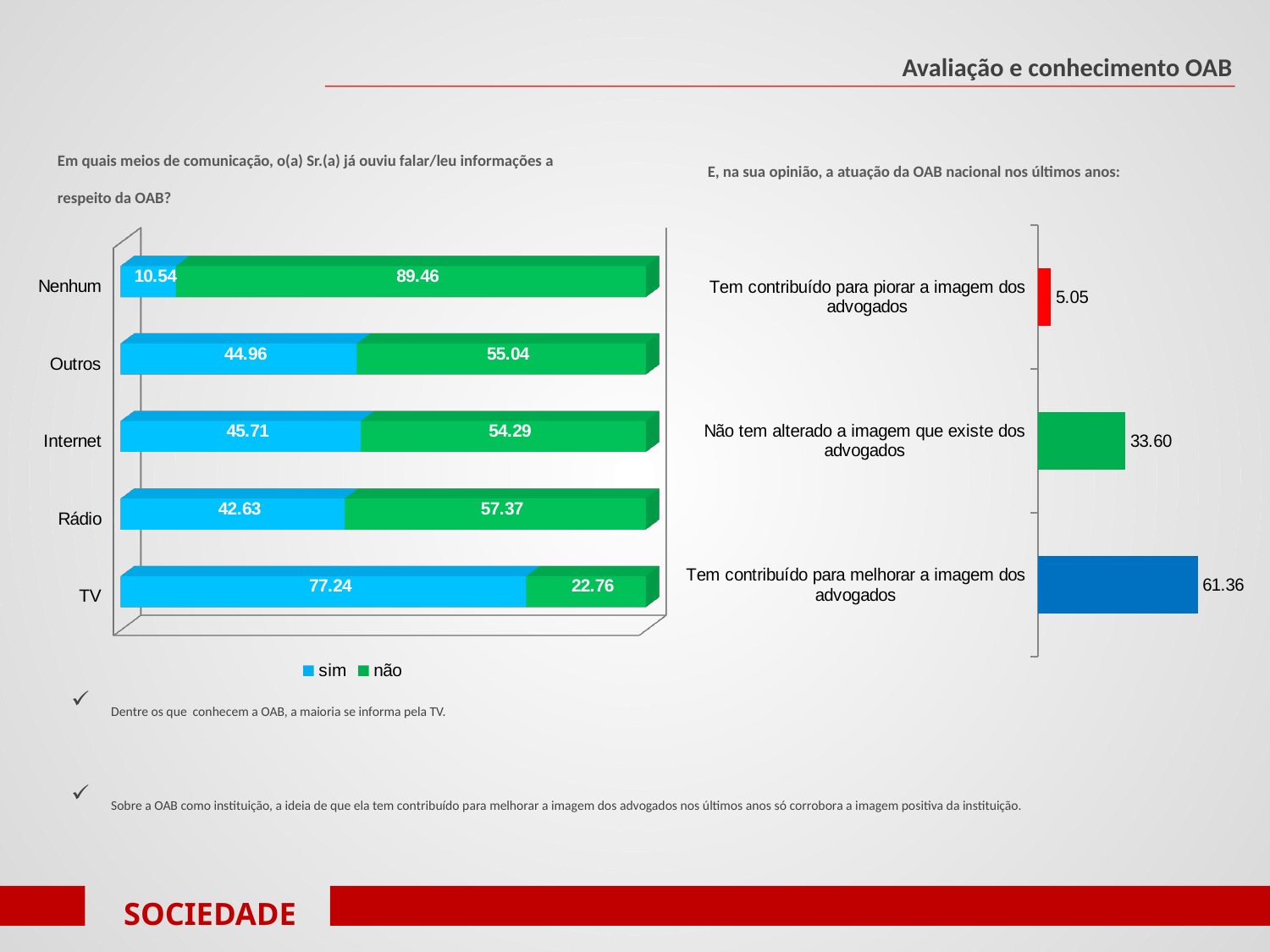
In the left chart (media through which respondents heard about OAB), which category has the highest 'sim' value? TV In the left chart (media through which respondents heard about OAB), how many series does the legend list? 2 In the left chart (media through which respondents heard about OAB), which category has the lowest 'sim' value? Nenhum What kind of chart is the right chart (opinion on OAB's performance in recent years)? Bar chart In the right chart (opinion on OAB's performance in recent years), which category has the lowest value? Tem contribuído para piorar a imagem dos advogados In the left chart (media through which respondents heard about OAB), what is the 'não' value for Nenhum? 89.46 In the left chart (media through which respondents heard about OAB), what is the 'sim' value for TV? 77.24 In the left chart (media through which respondents heard about OAB), how many categories are shown? 5 In the right chart (opinion on OAB's performance in recent years), what is the difference between 'Tem contribuído para melhorar a imagem dos advogados' and 'Não tem alterado a imagem que existe dos advogados'? 27.76 In the left chart (media through which respondents heard about OAB), what is the total of the stacked bar for Internet? 100.00 In the left chart (media through which respondents heard about OAB), what is the difference between the 'não' and 'sim' values for Rádio? 14.74 In the right chart (opinion on OAB's performance in recent years), what is the value for 'Tem contribuído para melhorar a imagem dos advogados'? 61.36